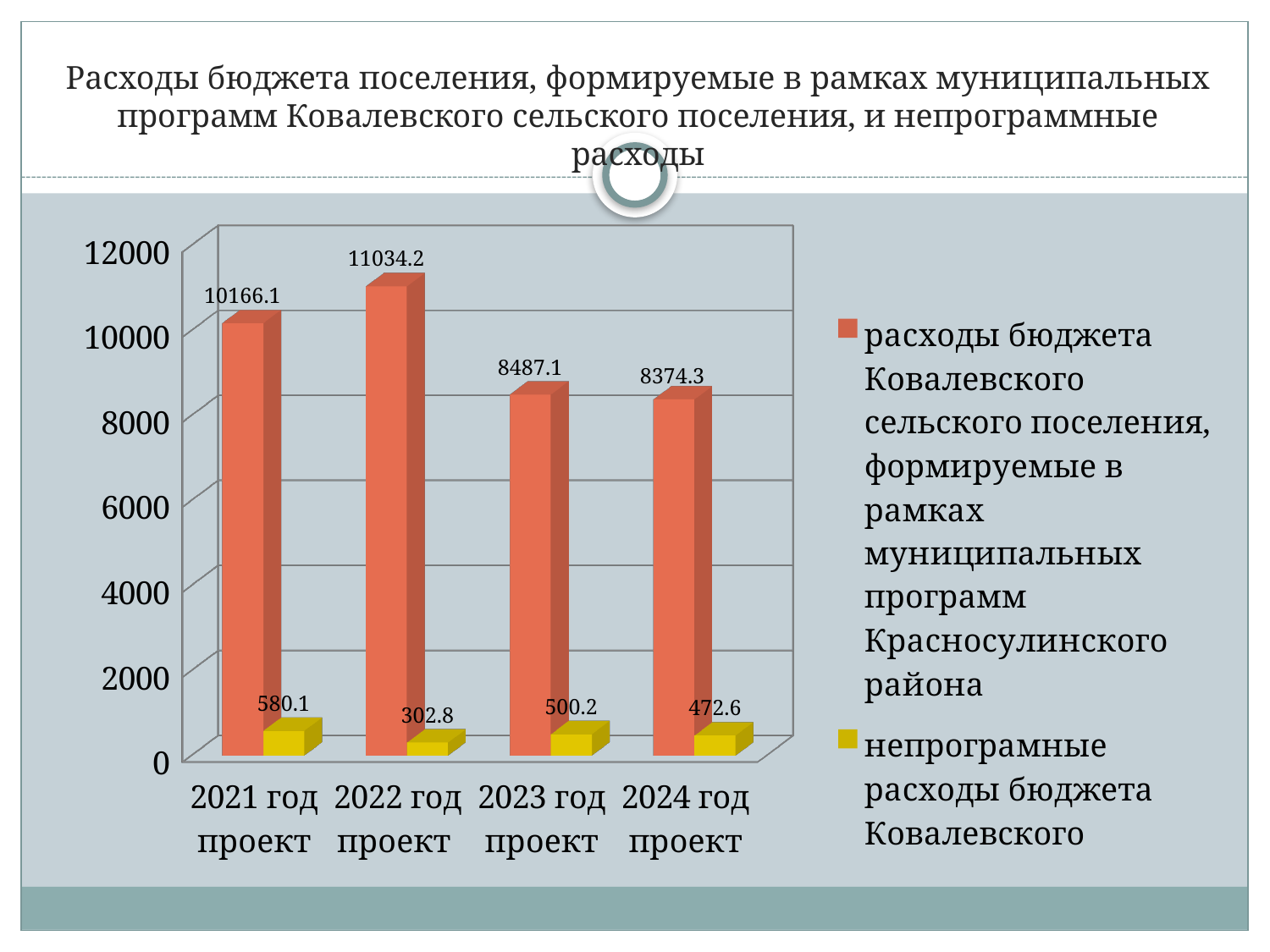
What is the value of the program budget expenses (orange series) for 2024 год проект? 8374.3 What is the difference between the non-program budget expenses for 2021 год проект and 2022 год проект? 277.3 What kind of chart is shown on the slide? Bar chart What is the difference between the program budget expenses for 2022 год проект and 2021 год проект? 868.1 What is the value of the program budget expenses (orange series) for 2022 год проект? 11034.2 What is the value of the non-program budget expenses (yellow series) for 2021 год проект? 580.1 In which year are the non-program budget expenses (yellow series) the lowest? 2022 год проект How many series does the legend list? 2 In which year are the program budget expenses (orange series) the highest? 2022 год проект Which is larger: the program budget expenses for 2023 год проект or for 2024 год проект? 2023 год проект How many year categories are shown on the x axis? 4 Is the value of the program budget expenses for 2021 год проект greater or less than 10000? greater